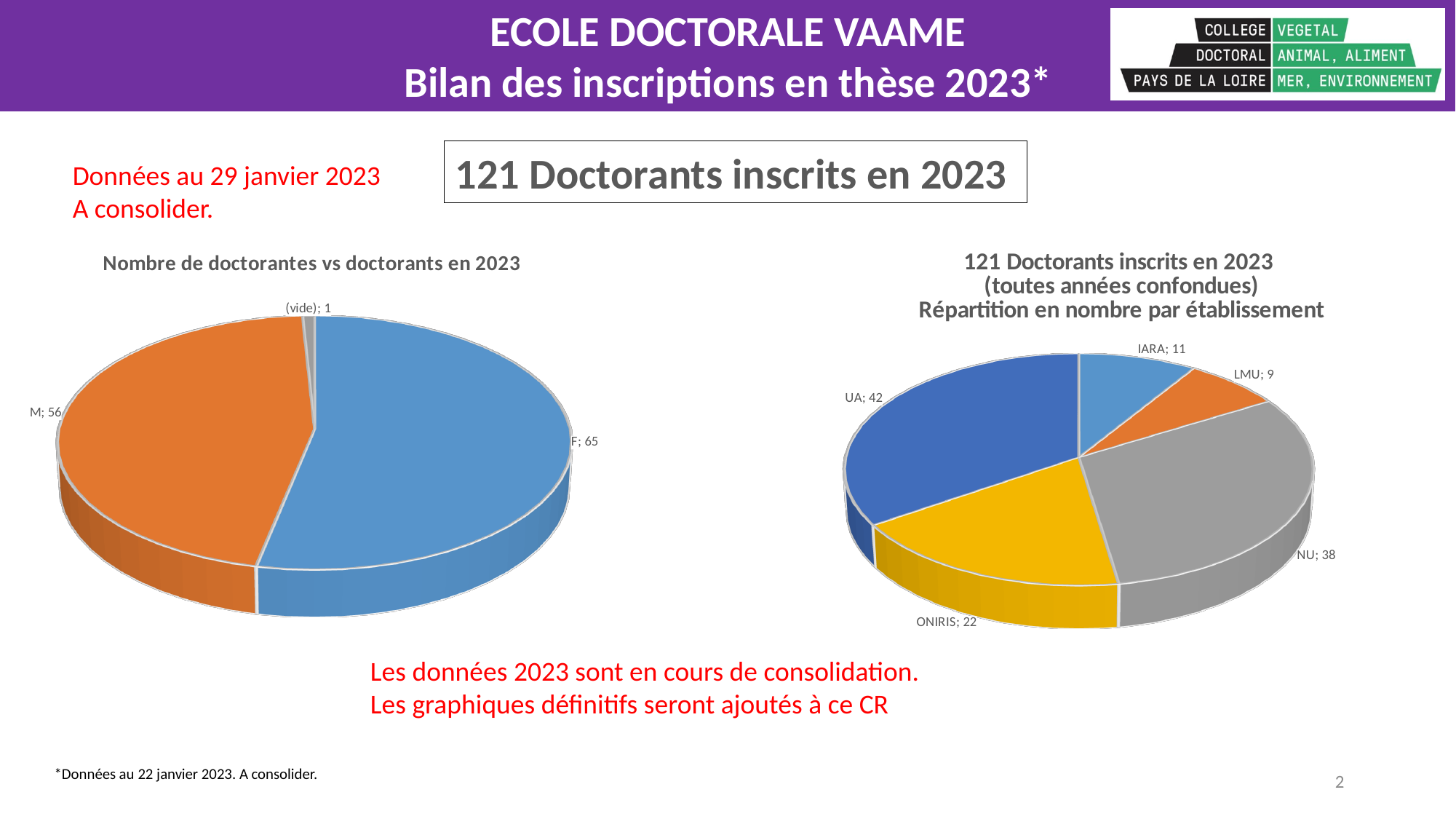
In the chart 'Nombre de doctorantes vs doctorants en 2023', what is the difference between the F and M values? 9 In the chart 'Nombre de doctorantes vs doctorants en 2023', which category has the smallest slice? (vide) In the chart 'Nombre de doctorantes vs doctorants en 2023', what is the value for M? 56 In the chart 'Nombre de doctorantes vs doctorants en 2023', what is the value for F? 65 In the right-hand chart 'Répartition en nombre par établissement', how many establishments are shown? 5 In the right-hand chart 'Répartition en nombre par établissement', which establishment has the smallest slice? LMU What kind of chart is 'Nombre de doctorantes vs doctorants en 2023'? Pie chart In the right-hand chart 'Répartition en nombre par établissement', what is the value for ONIRIS? 22 In the right-hand chart 'Répartition en nombre par établissement', what is the difference between the UA and NU values? 4 In the right-hand chart 'Répartition en nombre par établissement', which is larger, IARA or LMU? IARA In the right-hand chart 'Répartition en nombre par établissement', which establishment has the largest slice? UA In the right-hand chart 'Répartition en nombre par établissement', what is the value for UA? 42